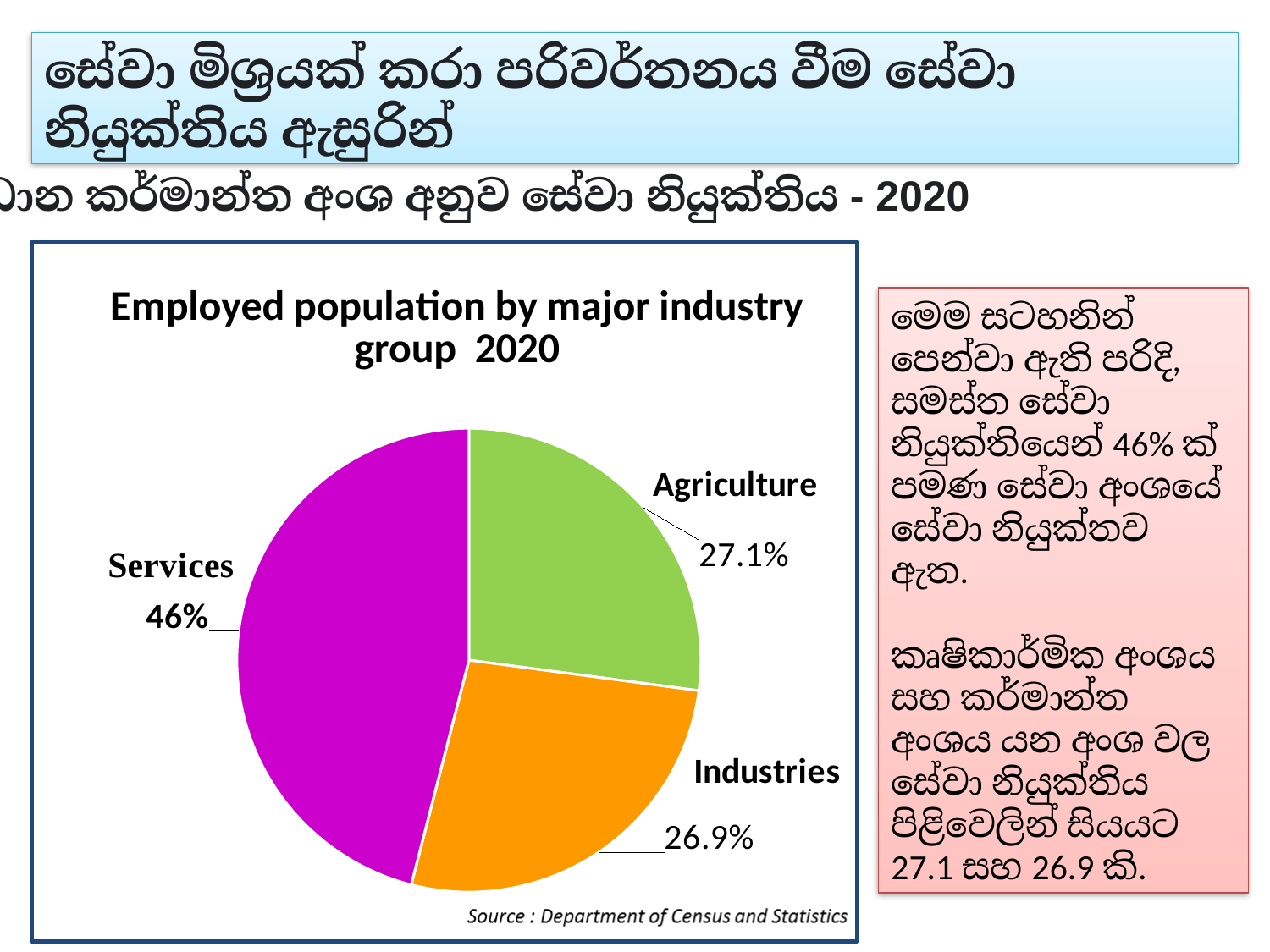
What colour is the Services slice? Magenta Which industry group has the largest share of the employed population? Services What share of the employed population is in Industries? 26.9% How many slices does the pie chart have? 3 What type of chart is shown on the slide? Pie chart What is the title of the chart? Employed population by major industry group 2020 What share of the employed population is in Services? 46% What is the difference in percentage points between the Agriculture share and the Industries share? 0.2 Which is larger, the Services share or the Industries share? Services What is the difference in percentage points between the Services share and the Agriculture share? 18.9 What is the source cited for the chart? Department of Census and Statistics What share of the employed population is in Agriculture? 27.1%